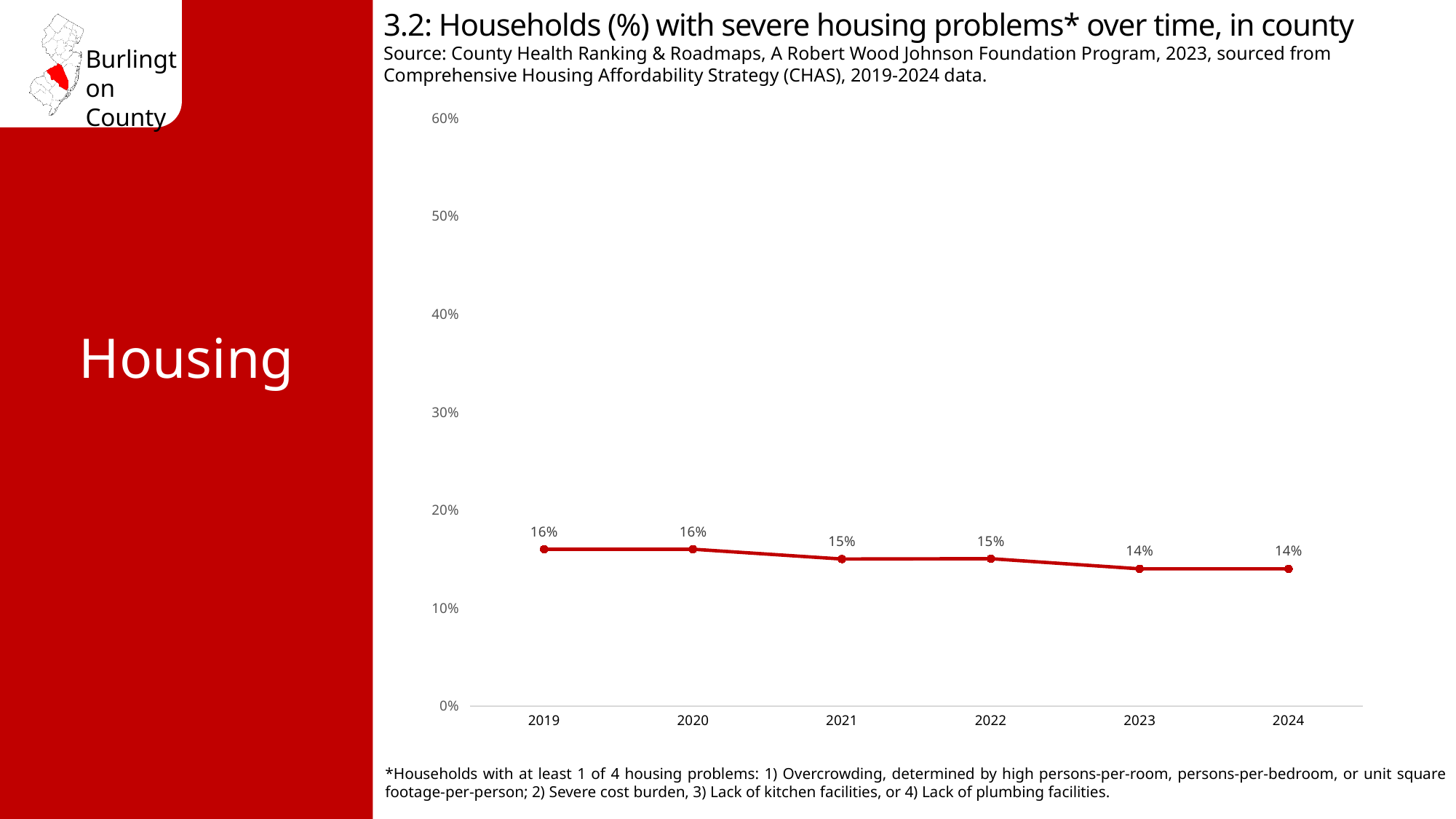
What percentage of households had severe housing problems in 2021? 15% Is the value for 2022 greater or less than 20%? less Do the values rise or fall from 2019 to 2024? fall What percentage of households had severe housing problems in 2024? 14% What is the difference between the 2019 value and the 2024 value? 2% What is the highest value shown on the chart? 16% What percentage of households had severe housing problems in 2019? 16% What is the lowest value shown on the chart? 14% What kind of chart is shown on the slide? line chart Which is larger, the value for 2020 or the value for 2023? 2020 How many years are plotted on the chart? 6 What is the title of the chart? 3.2: Households (%) with severe housing problems* over time, in county